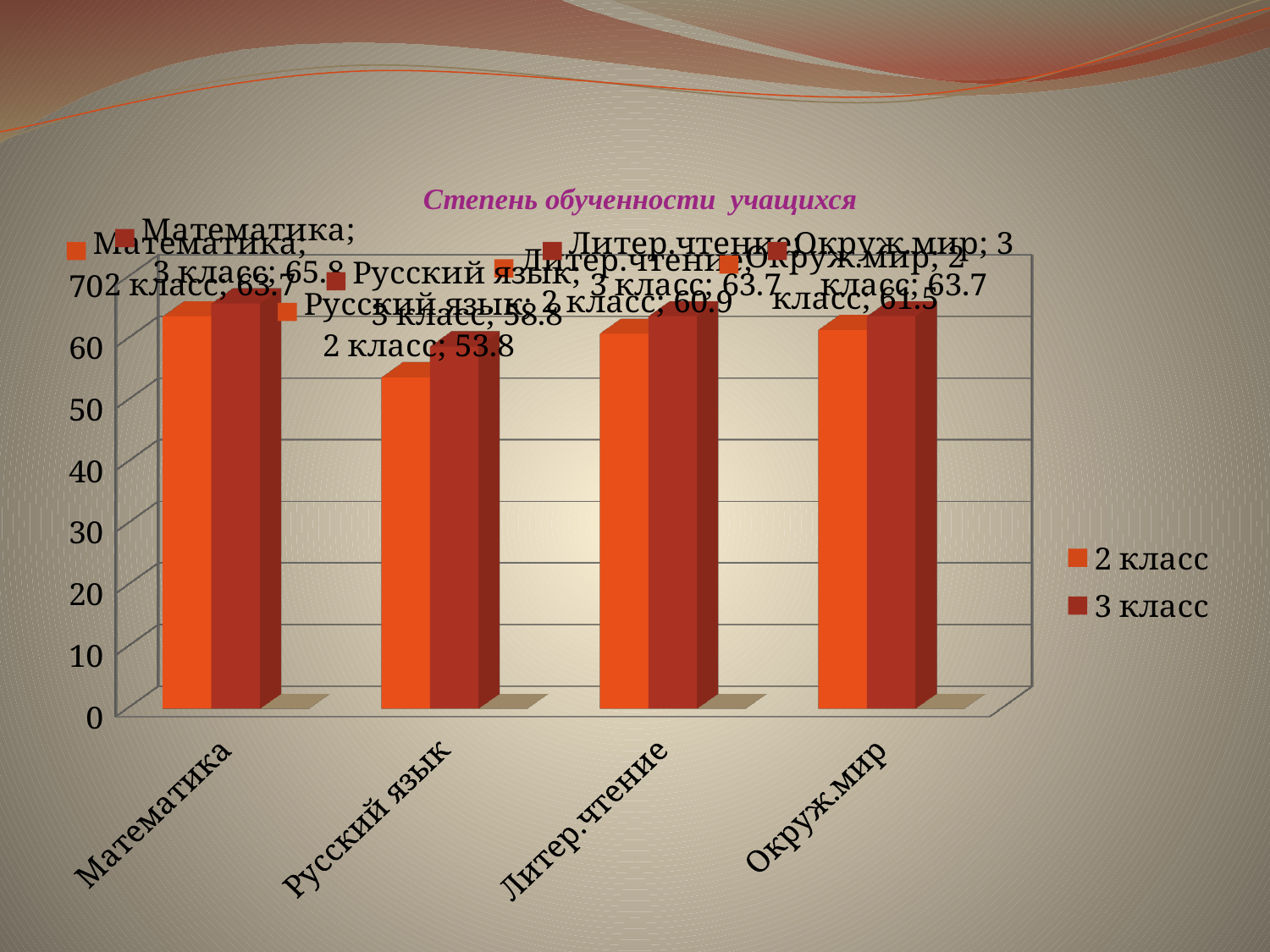
Which category has the highest value in the 3 класс series? Математика Which is larger for Математика: the 2 класс value or the 3 класс value? 3 класс What kind of chart is shown on the slide? Bar chart How many categories are shown on the x axis? 4 What is the value for Русский язык in the 2 класс series? 53.8 Is the 2 класс value for Русский язык greater or less than 60? less How many series does the legend list? 2 Which category has the lowest value in the 2 класс series? Русский язык What is the value for Математика in the 3 класс series? 65.8 What is the value for Окруж.мир in the 3 класс series? 63.7 What is the difference between the 3 класс and 2 класс values for Русский язык? 5 What is the value for Литер.чтение in the 2 класс series? 60.9